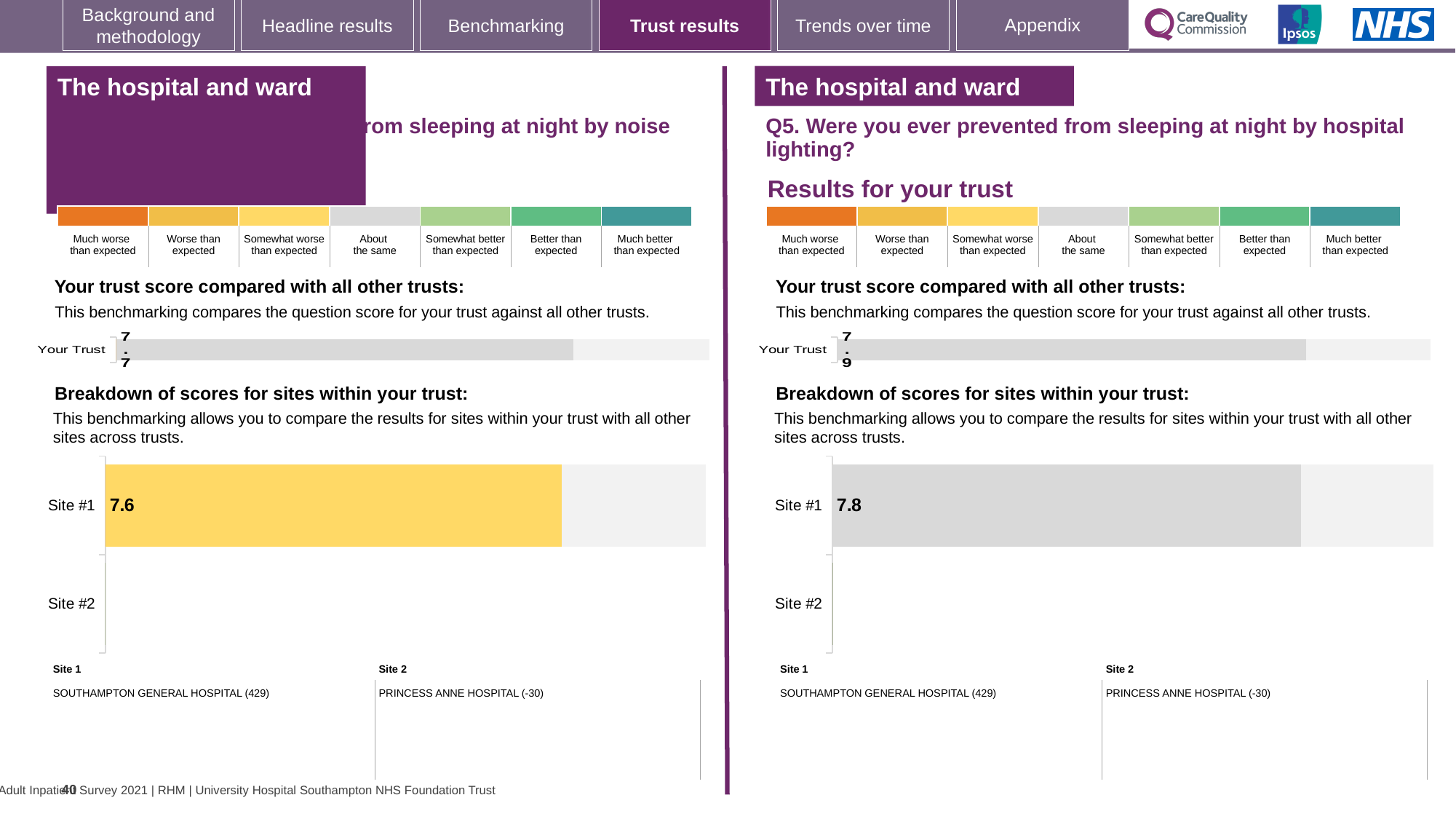
On the right-hand 'Breakdown of scores for sites within your trust' chart (Q5, hospital lighting), what is the score for Site #1? 7.8 On the left-hand breakdown chart (noise), what colour is the Site #1 bar? Yellow On the left-hand 'Your trust score compared with all other trusts' chart (sleeping at night by noise), what is the score for Your Trust? 7.7 How many sites are listed on the left-hand 'Breakdown of scores for sites within your trust' chart? 2 What is the difference between the Site #1 score on the right-hand breakdown chart (Q5, hospital lighting) and the Site #1 score on the left-hand breakdown chart (noise)? 0.2 Which site is named as Site 1 beneath the breakdown charts? SOUTHAMPTON GENERAL HOSPITAL (429) On the left-hand side (noise), what is the difference between the Your Trust score and the Site #1 score? 0.1 What type of chart is the right-hand 'Breakdown of scores for sites within your trust' chart? Bar chart On the left-hand 'Breakdown of scores for sites within your trust' chart (noise), what is the score for Site #1? 7.6 What is the difference between the Your Trust score for Q5 (hospital lighting, right) and the Your Trust score for the noise question (left)? 0.2 Which is larger: the Your Trust score on the left-hand chart (noise) or the Your Trust score on the right-hand chart (Q5, hospital lighting)? Right-hand chart (Q5, hospital lighting) On the right-hand 'Your trust score compared with all other trusts' chart (Q5, hospital lighting), what is the score for Your Trust? 7.9